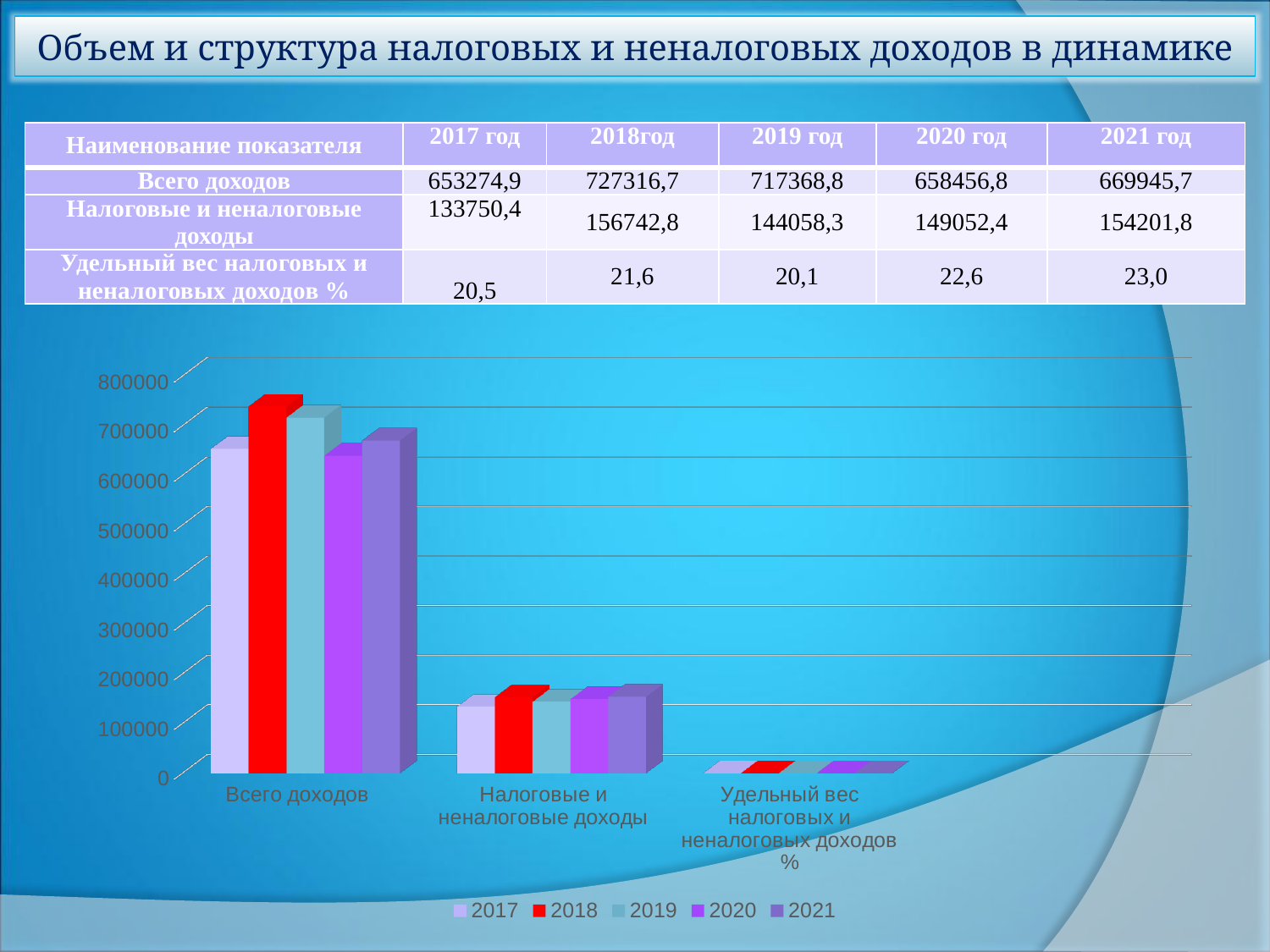
By how much does "Всего доходов" in 2018 exceed "Всего доходов" in 2017? 74041,8 Is the 2017 value for "Всего доходов" greater or less than 700000? less What is the value of "Удельный вес налоговых и неналоговых доходов %" for 2020 год? 22,6 How many series does the chart legend list? 5 What kind of chart is shown on the slide? bar chart Which is larger for "Налоговые и неналоговые доходы": the 2018 value or the 2019 value? 2018 How many categories are shown along the x axis of the chart? 3 Which year has the highest value for "Всего доходов"? 2018 Is the 2018 value for "Налоговые и неналоговые доходы" greater or less than 200000? less Which colour represents the 2018 series in the chart legend? red Is the 2018 value for "Всего доходов" greater or less than 700000? greater What is the value of "Всего доходов" for 2019 год? 717368,8